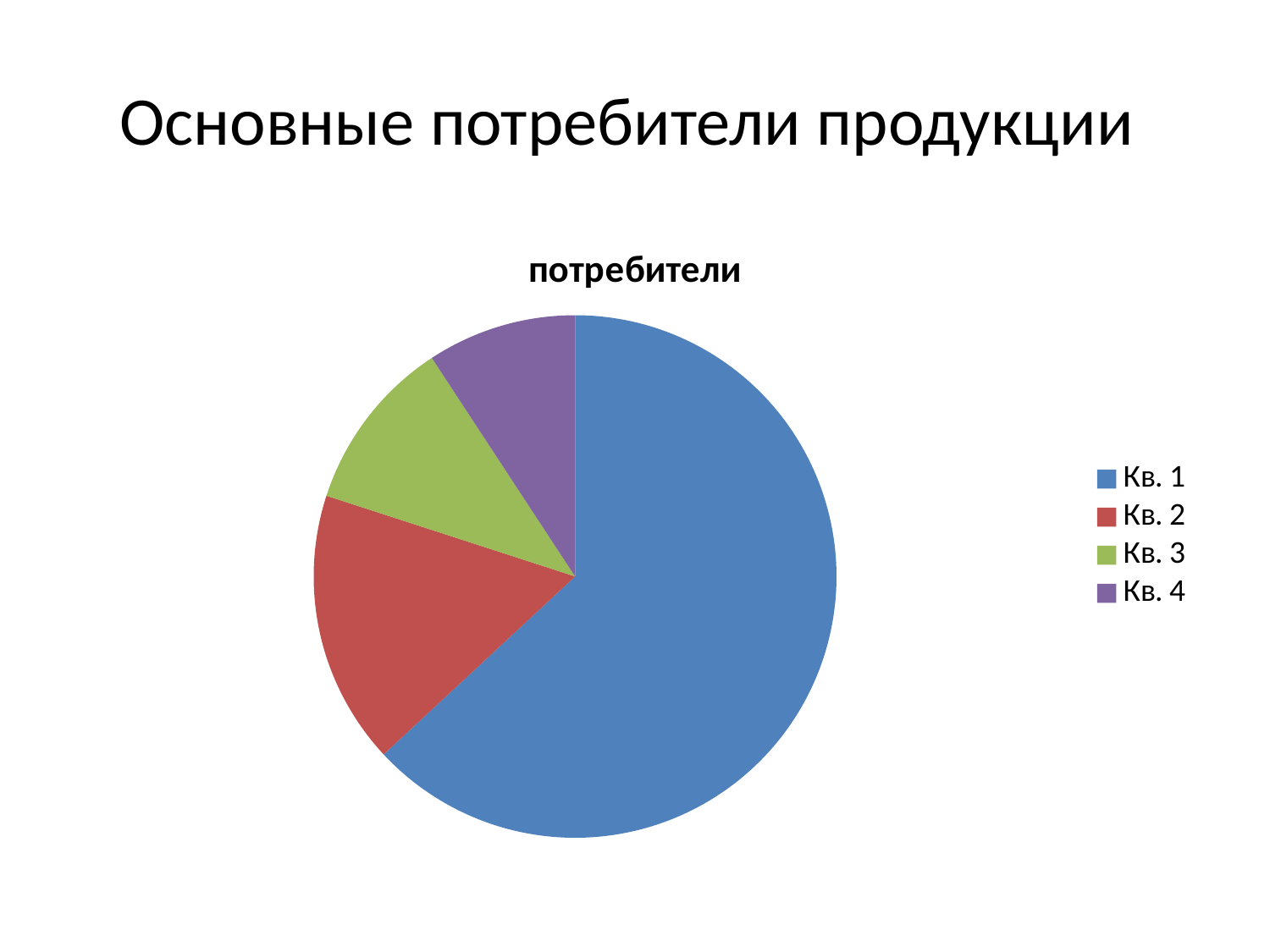
Which slice is larger, Кв. 3 or Кв. 4? Кв. 3 What kind of chart is shown on the slide? pie chart Which category has the largest slice of the pie chart? Кв. 1 Does the Кв. 1 slice take up more or less than half of the pie? more What is the title of the pie chart? потребители Which slice is larger, Кв. 2 or Кв. 3? Кв. 2 Which slice is larger, Кв. 1 or Кв. 2? Кв. 1 Which category has the smallest slice of the pie chart? Кв. 4 How many entries does the legend of the pie chart list? 4 What colour is the Кв. 1 slice in the pie chart? blue How many slices does the pie chart have? 4